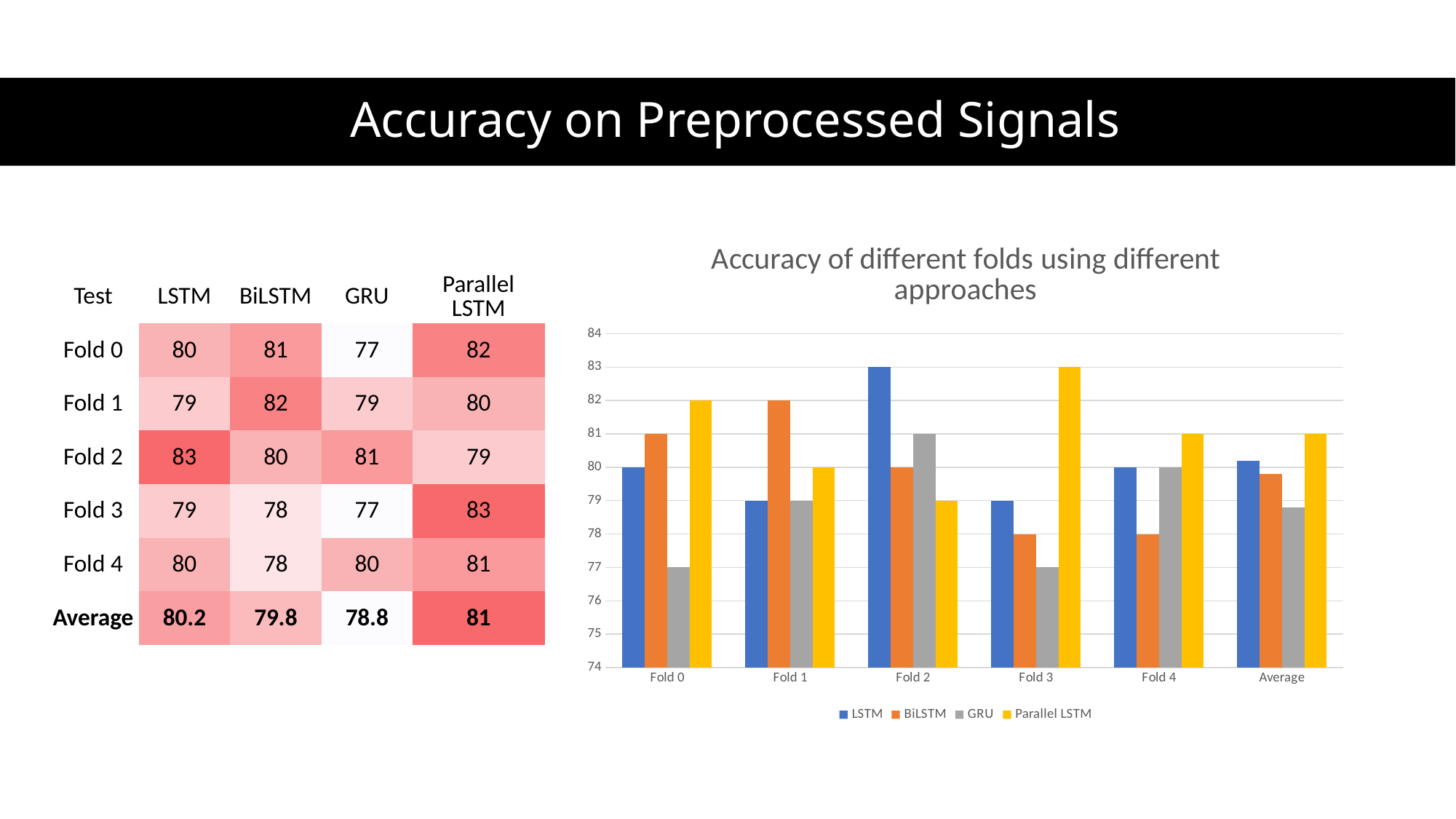
What is the title of the chart? Accuracy of different folds using different approaches What type of chart is shown on the slide? bar chart For Fold 4, which is larger: the accuracy of LSTM or BiLSTM? LSTM Which approach has the lowest accuracy for Fold 0? GRU What is the average accuracy of GRU? 78.8 What is the accuracy of Parallel LSTM for Fold 3? 83 What is the accuracy of LSTM for Fold 2? 83 Which approach has the highest accuracy for Fold 1? BiLSTM How many series does the chart legend list? 4 What is the difference between the Parallel LSTM and GRU accuracies for Fold 3? 6 How many categories are shown on the x axis of the chart? 6 Is the GRU accuracy for Fold 2 greater or less than 80? greater